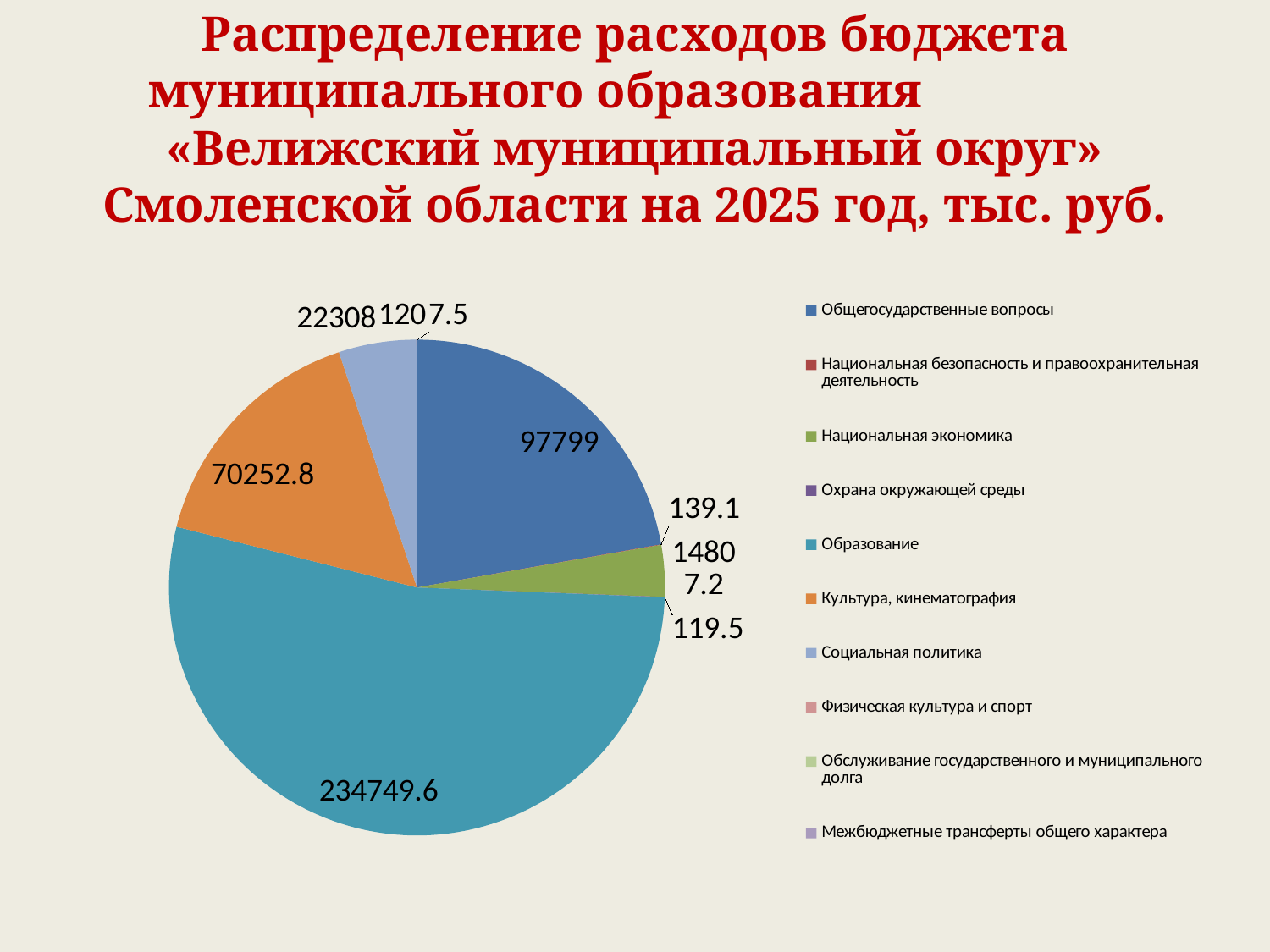
How many categories does the legend list? 10 What is the difference between Образование and Культура, кинематография? 164496.8 Which is larger, Общегосударственные вопросы or Образование? Образование What is the value for Социальная политика? 22308 What is the value for Национальная экономика? 14807.2 What is the value for Культура, кинематография? 70252.8 What kind of chart is shown on the slide? pie chart What is the value for Общегосударственные вопросы? 97799 What is the value for Образование? 234749.6 Which category has the largest slice of the pie? Образование Which is larger, Культура, кинематография or Социальная политика? Культура, кинематография What is the difference between Общегосударственные вопросы and Культура, кинематография? 27546.2